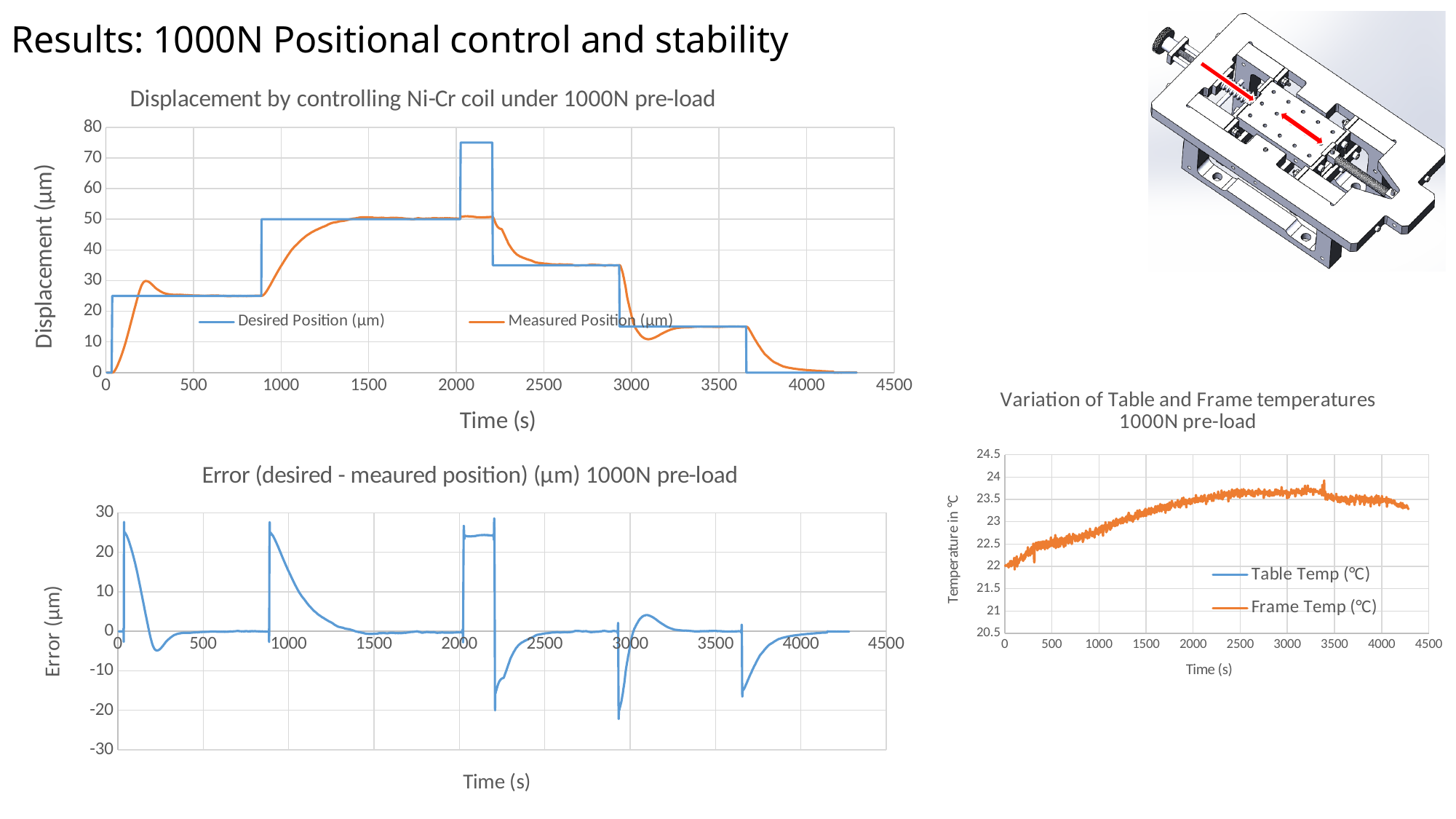
In the 'Displacement by controlling Ni-Cr coil under 1000N pre-load' chart, what is the Desired Position at 1500 s? 50 µm In the 'Displacement by controlling Ni-Cr coil under 1000N pre-load' chart, is the Desired Position at 2100 s greater or less than 70? greater In the 'Displacement by controlling Ni-Cr coil under 1000N pre-load' chart, which series is drawn in orange? Measured Position (µm) In the 'Error (desired - meaured position) (µm) 1000N pre-load' chart, is the peak error just after 900 s greater or less than 20? greater In the 'Error (desired - meaured position) (µm) 1000N pre-load' chart, is the error at 2100 s greater or less than 20? greater How many series does the legend of the 'Displacement by controlling Ni-Cr coil under 1000N pre-load' chart list? 2 What is the y-axis label of the 'Error (desired - meaured position) (µm) 1000N pre-load' chart? Error (µm) In the 'Variation of Table and Frame temperatures 1000N pre-load' chart, does the Frame Temp rise or fall between 0 s and 2500 s? rise What kind of chart is the 'Displacement by controlling Ni-Cr coil under 1000N pre-load' chart? line chart How many series does the legend of the 'Variation of Table and Frame temperatures 1000N pre-load' chart list? 2